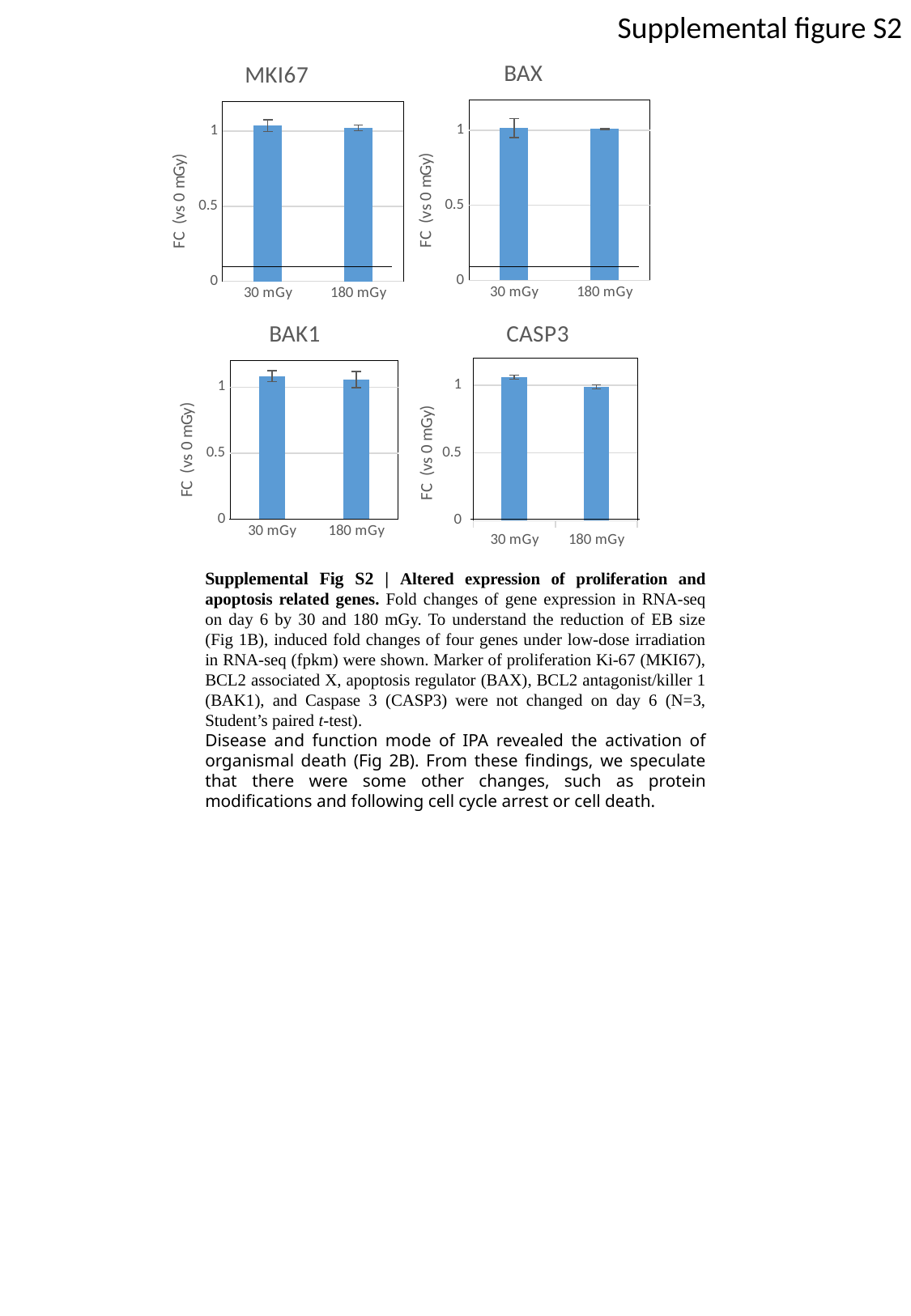
How many categories are shown on the x axis of the BAX chart? 2 What are the two x-axis categories in the BAK1 chart? 30 mGy and 180 mGy In the BAK1 chart, is the value for 30 mGy greater or less than 0.5? greater What is the y-axis label of the BAK1 chart? FC (vs 0 mGy) In the BAX chart, is the value for 180 mGy greater or less than 0.5? greater How many bar charts are shown on the slide? 4 What kind of chart is the MKI67 chart? bar chart In the CASP3 chart, is the value for 180 mGy greater or less than 0.5? greater In the CASP3 chart, which category has the larger value, 30 mGy or 180 mGy? 30 mGy What is the title of the chart in the bottom-right position? CASP3